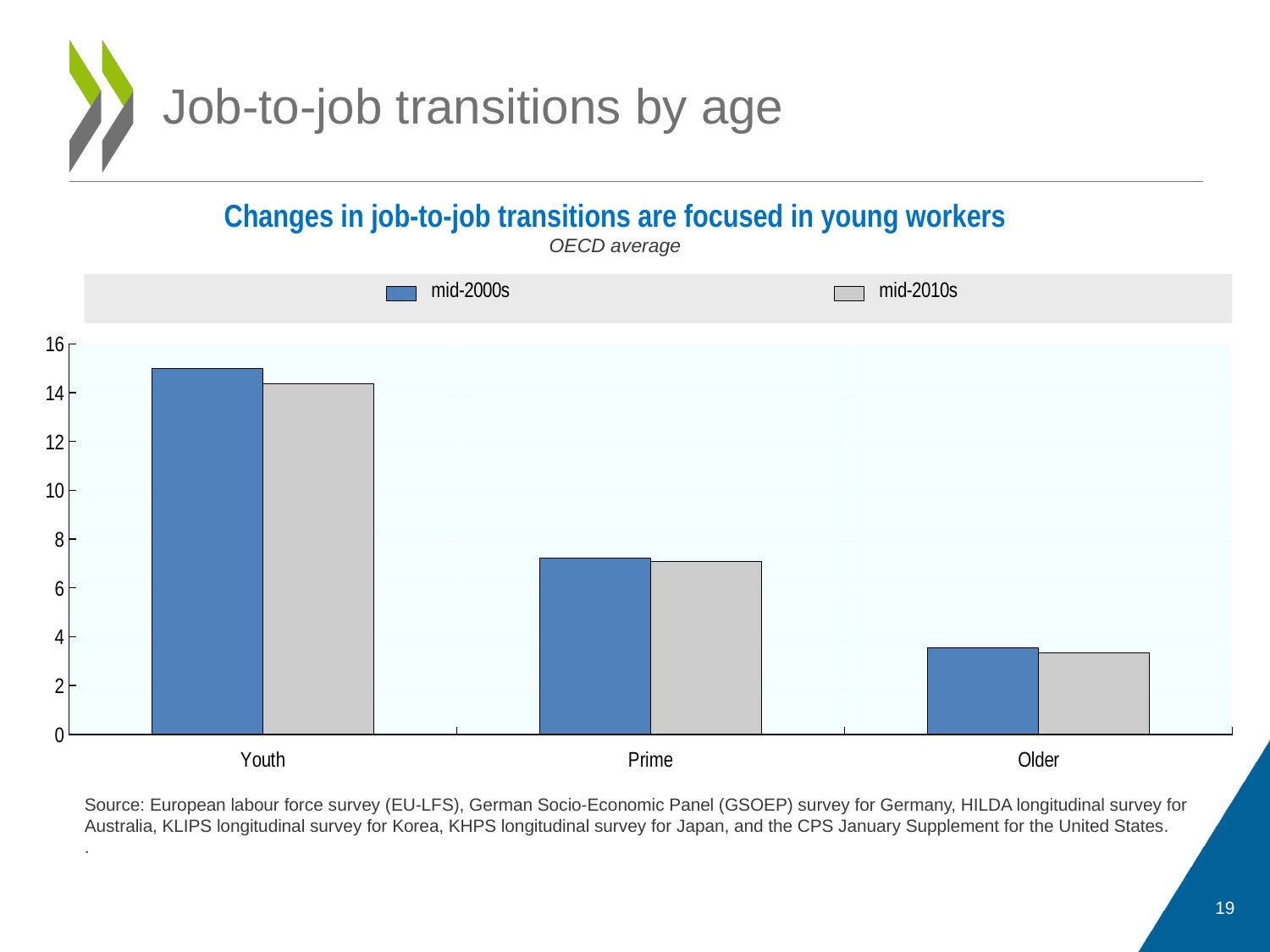
Which colour represents the mid-2010s series in the legend? grey For Youth, which is larger: the mid-2000s value or the mid-2010s value? mid-2000s What kind of chart is shown on the slide? bar chart Which age category has the lowest job-to-job transition rate in the mid-2010s? Older Is the mid-2000s value for Youth greater or less than 14? greater Is the mid-2010s value for Youth greater or less than 12? greater Do the mid-2000s values rise or fall moving from Youth to Prime to Older? fall Which age category has the highest job-to-job transition rate in the mid-2000s? Youth Is the mid-2010s value for Older greater or less than 4? less How many age categories are shown on the x axis? 3 How many series does the legend list? 2